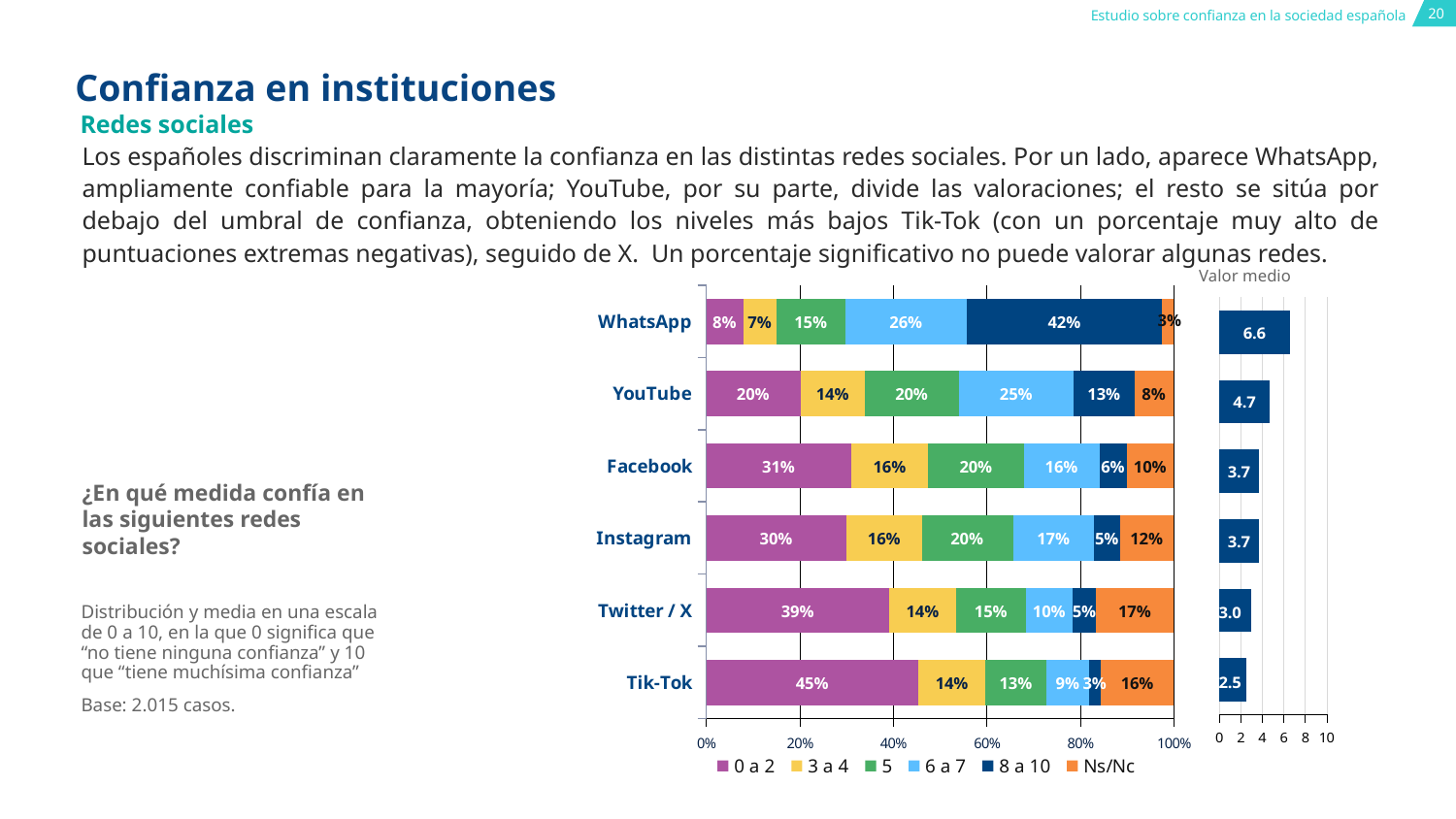
In the stacked bar chart, which social network has the highest percentage in the 0 a 2 category? Tik-Tok In the Valor medio chart, which social network has the lowest mean value? Tik-Tok How many social networks are shown in the stacked bar chart? 6 In the stacked bar chart, which is larger: the Ns/Nc percentage for Twitter / X or for Instagram? Twitter / X In the Valor medio chart, what is the difference between the mean value for WhatsApp and for Tik-Tok? 4.1 In the Valor medio chart, what is the mean value for YouTube? 4.7 In the stacked bar chart, what percentage of respondents gave Tik-Tok a score of 0 a 2? 45% In the stacked bar chart, what is the difference between the 0 a 2 percentage for Twitter / X and for Facebook? 8% What kind of chart is the Valor medio chart? Bar chart In the Valor medio chart, which social network has the highest mean value? WhatsApp How many series does the legend of the stacked bar chart list? 6 In the stacked bar chart, what percentage of respondents gave WhatsApp a score of 8 a 10? 42%